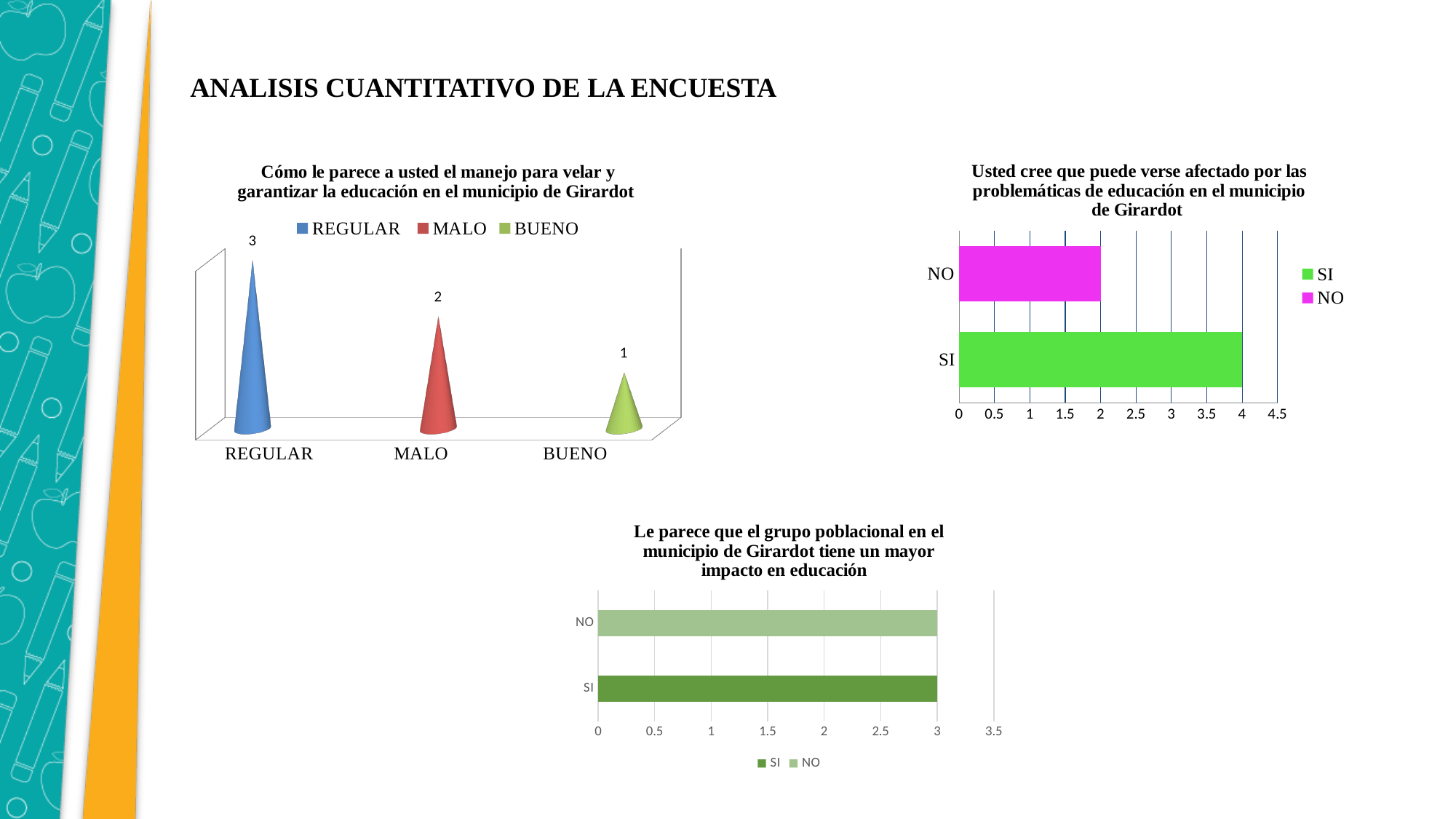
In the chart titled 'Cómo le parece a usted el manejo para velar y garantizar la educación en el municipio de Girardot', what is the value for BUENO? 1 In the chart titled 'Cómo le parece a usted el manejo para velar y garantizar la educación en el municipio de Girardot', what is the value for REGULAR? 3 In the chart titled 'Usted cree que puede verse afectado por las problemáticas de educación en el municipio de Girardot', which is larger, SI or NO? SI In the chart titled 'Usted cree que puede verse afectado por las problemáticas de educación en el municipio de Girardot', what is the value for SI? 4 In the chart titled 'Cómo le parece a usted el manejo para velar y garantizar la educación en el municipio de Girardot', how many entries does the legend list? 3 In the chart titled 'Cómo le parece a usted el manejo para velar y garantizar la educación en el municipio de Girardot', what is the difference between REGULAR and MALO? 1 In the chart titled 'Le parece que el grupo poblacional en el municipio de Girardot tiene un mayor impacto en educación', what is the value for SI? 3 In the chart titled 'Le parece que el grupo poblacional en el municipio de Girardot tiene un mayor impacto en educación', is the value for NO greater or less than 2? greater In the chart titled 'Cómo le parece a usted el manejo para velar y garantizar la educación en el municipio de Girardot', which category has the highest value? REGULAR In the chart titled 'Cómo le parece a usted el manejo para velar y garantizar la educación en el municipio de Girardot', how many categories are shown? 3 In the chart titled 'Usted cree que puede verse afectado por las problemáticas de educación en el municipio de Girardot', what is the value for NO? 2 What kind of chart is the one titled 'Usted cree que puede verse afectado por las problemáticas de educación en el municipio de Girardot'? bar chart